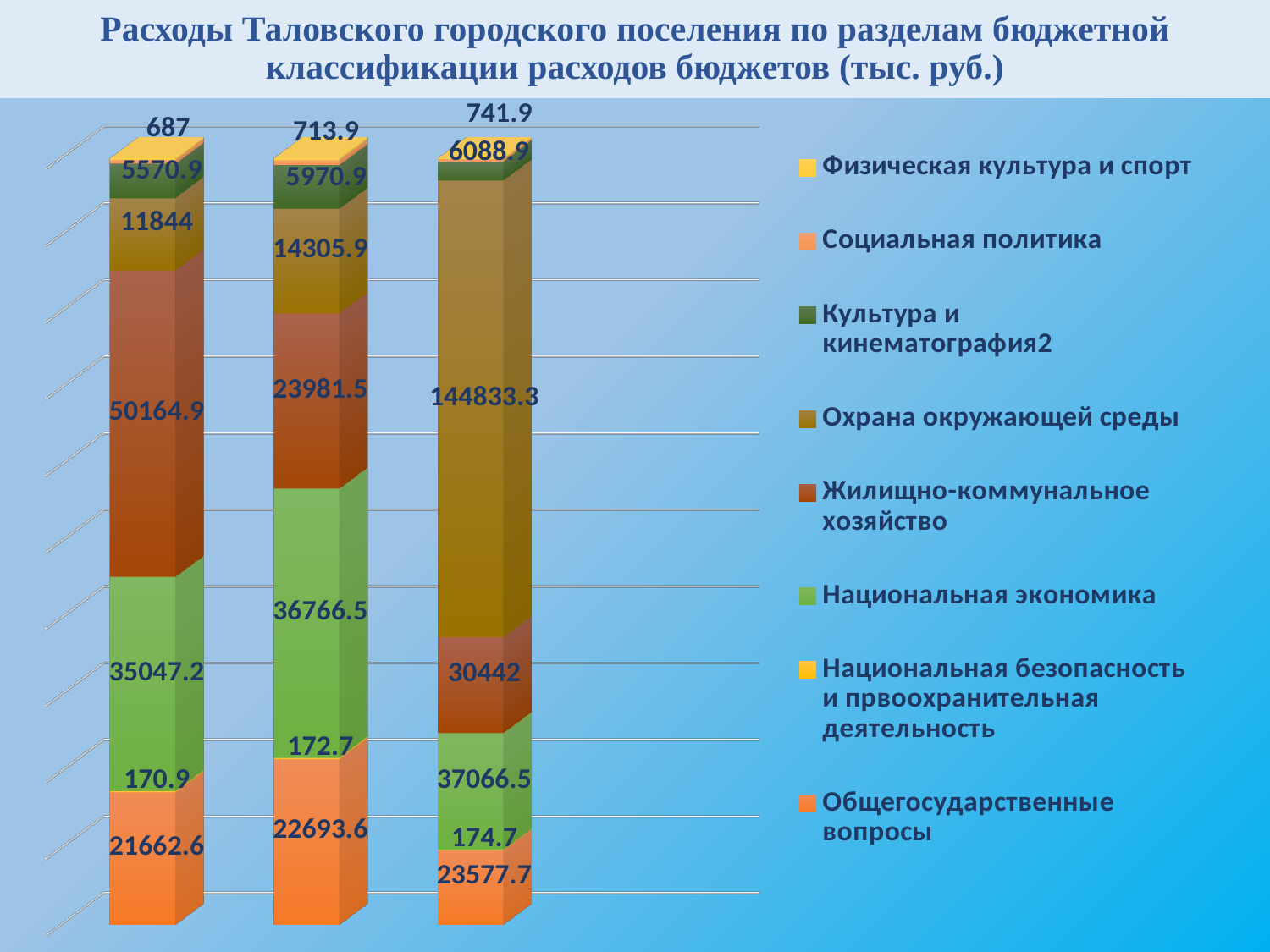
What is the value of the Национальная экономика segment in the middle bar? 36766.5 How many series does the legend list? 8 What is the difference between the Охрана окружающей среды segment in the right bar and in the middle bar? 130527.4 What is the value of the Общегосударственные вопросы segment in the right bar? 23577.7 What kind of chart is shown on the slide? Stacked bar chart Which is larger: the Жилищно-коммунальное хозяйство segment in the left bar or in the middle bar? Left bar Which segment is the largest in the left bar? Жилищно-коммунальное хозяйство How many stacked bars are plotted in the chart? 3 Which segment is the smallest in the right bar? Национальная безопасность и првоохранительная деятельность What is the value of the Жилищно-коммунальное хозяйство segment in the left bar? 50164.9 What is the value of the Охрана окружающей среды segment in the right bar? 144833.3